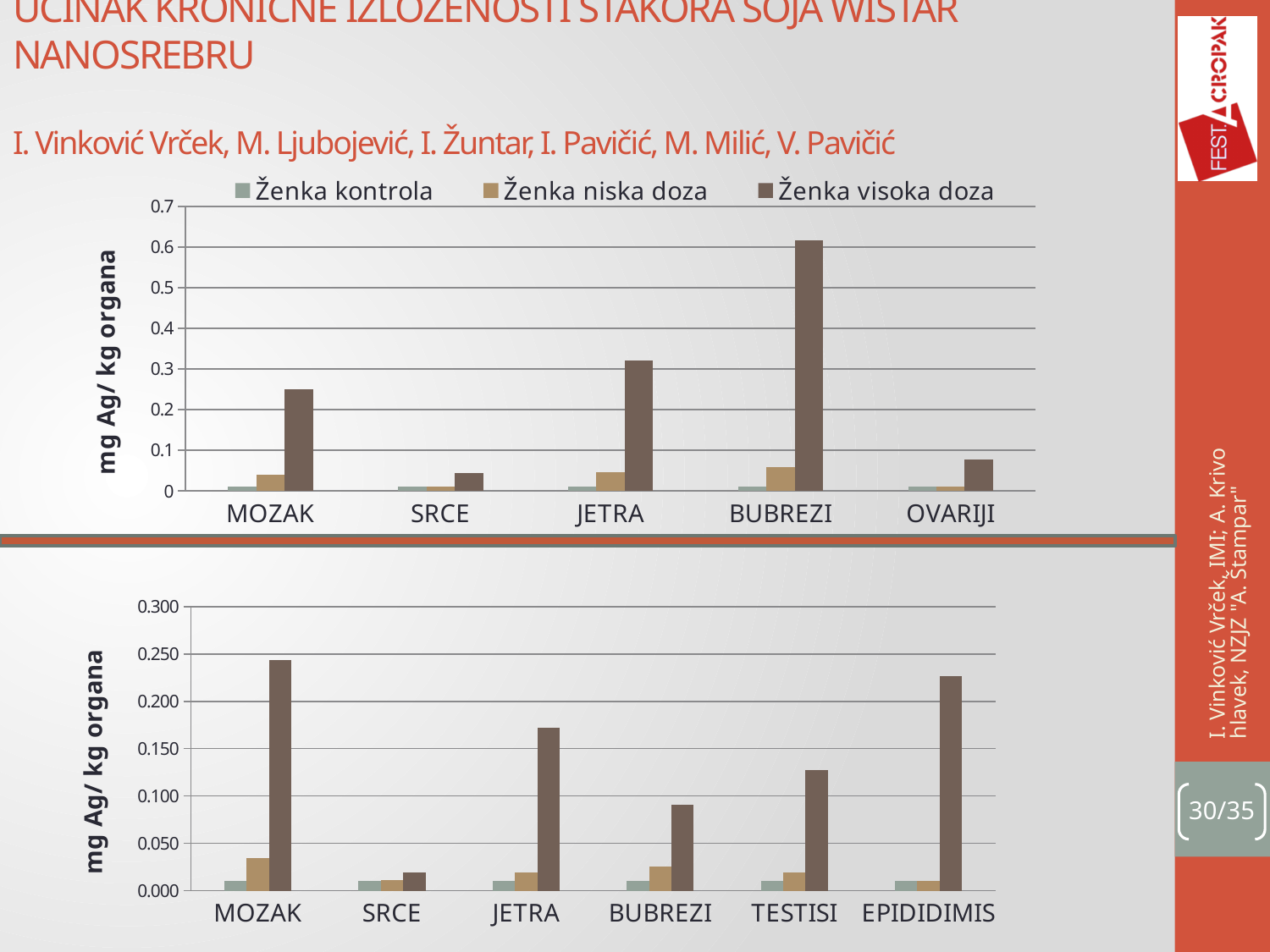
In the bottom chart, is the dark brown bar for JETRA greater or less than 0.150? greater What type of chart is the top chart on the slide? bar chart In the top chart, how many organ categories are shown on the x axis? 5 In the top chart, which is larger for Ženka visoka doza: JETRA or MOZAK? JETRA What is the y-axis label of the bottom chart? mg Ag/ kg organa How many series does the legend of the top chart list? 3 In the top chart, is the Ženka visoka doza value for OVARIJI greater or less than 0.1? less In the top chart, which organ has the lowest value for Ženka visoka doza? SRCE In the bottom chart, which organ has the lowest value for the dark brown (tallest) series? SRCE In the top chart, which organ has the highest value for Ženka visoka doza? BUBREZI In the bottom chart, how many organ categories are shown on the x axis? 6 In the top chart, is the Ženka visoka doza value for BUBREZI greater or less than 0.5? greater